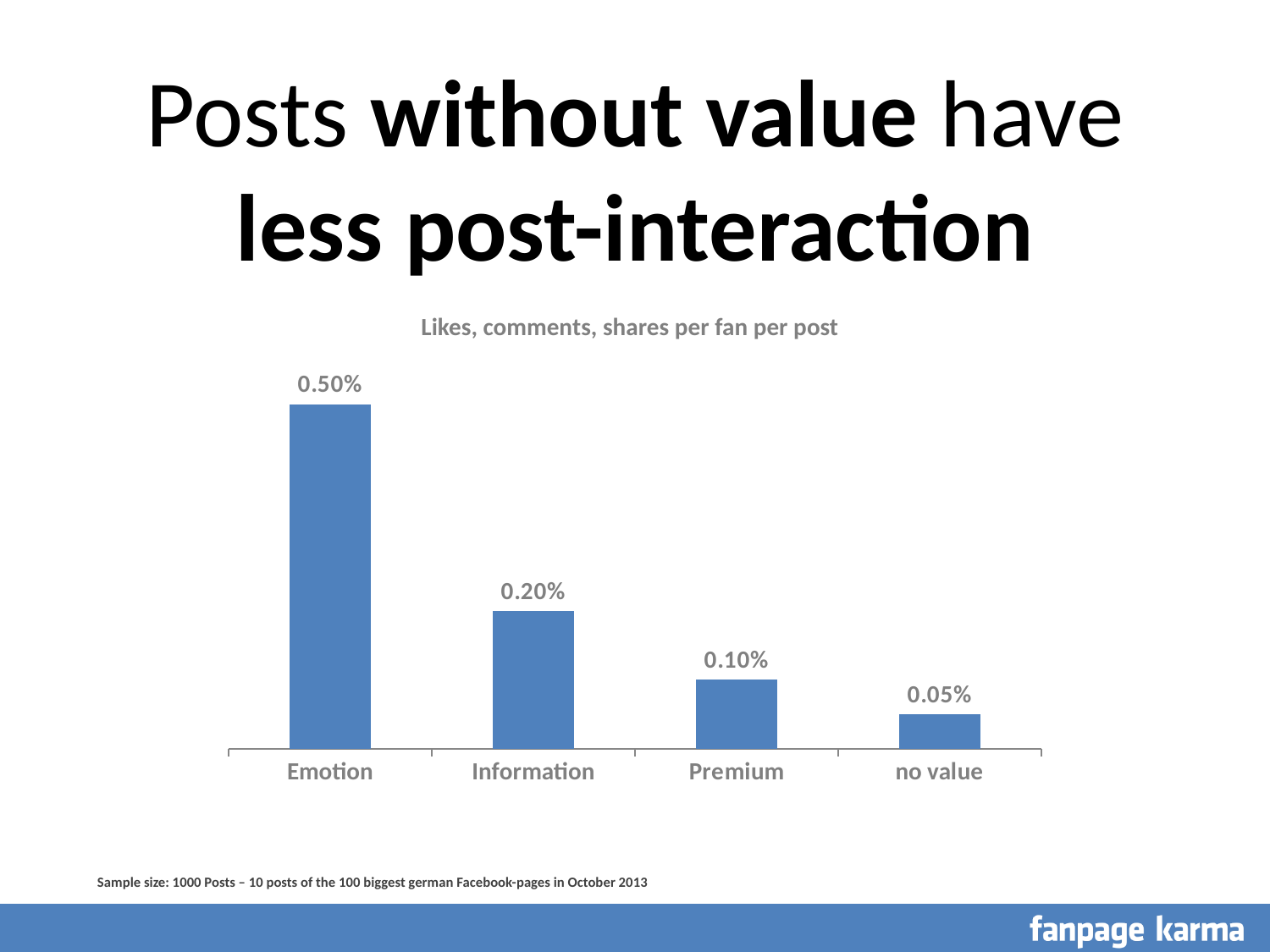
What is the value for Emotion? 0.50% What is the difference between the values for Premium and no value? 0.05% How many categories are shown in the chart? 4 What is the value for no value? 0.05% Which category has the lowest value? no value What is the title of the chart? Likes, comments, shares per fan per post What is the value for Information? 0.20% What is the difference between the values for Emotion and Information? 0.30% Which category has the highest value? Emotion What is the value for Premium? 0.10% What kind of chart is shown on the slide? bar chart Which is larger, the value for Information or the value for Premium? Information